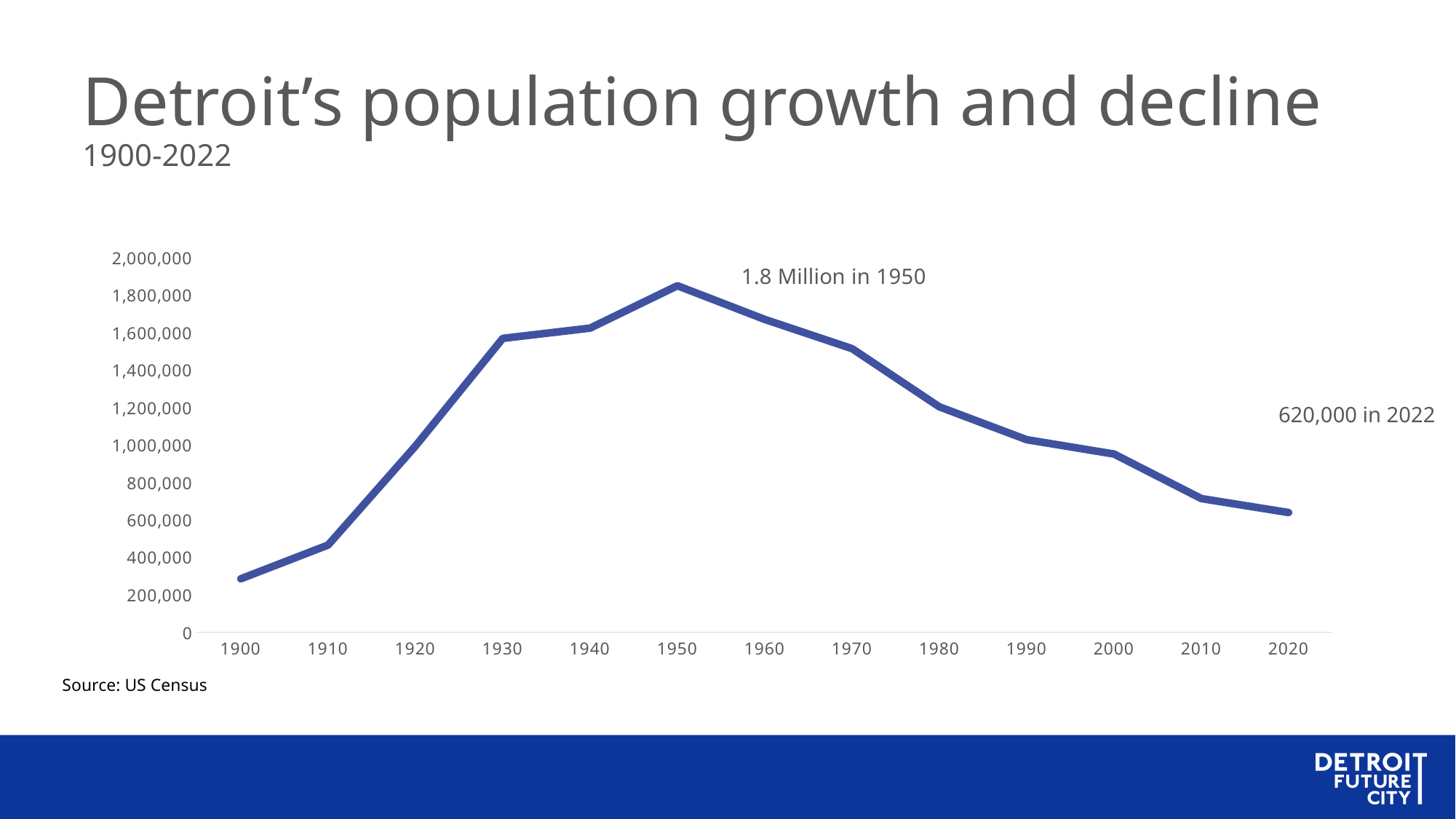
What kind of chart is shown on the slide? line chart Is the value for 1900 greater or less than 400,000? less Is the value for 1970 greater or less than 1,400,000? greater Which year has the larger population, 1920 or 1980? 1980 Is the value for 2010 greater or less than 800,000? less How many years are marked on the x axis of the chart? 13 Does Detroit's population rise or fall between 1950 and 2020? fall In which year does Detroit's population reach its highest point on the chart? 1950 According to the annotation on the chart, what was Detroit's population in 1950? 1.8 Million In which year is Detroit's population lowest on the chart? 1900 According to the annotation on the chart, what was Detroit's population in 2022? 620,000